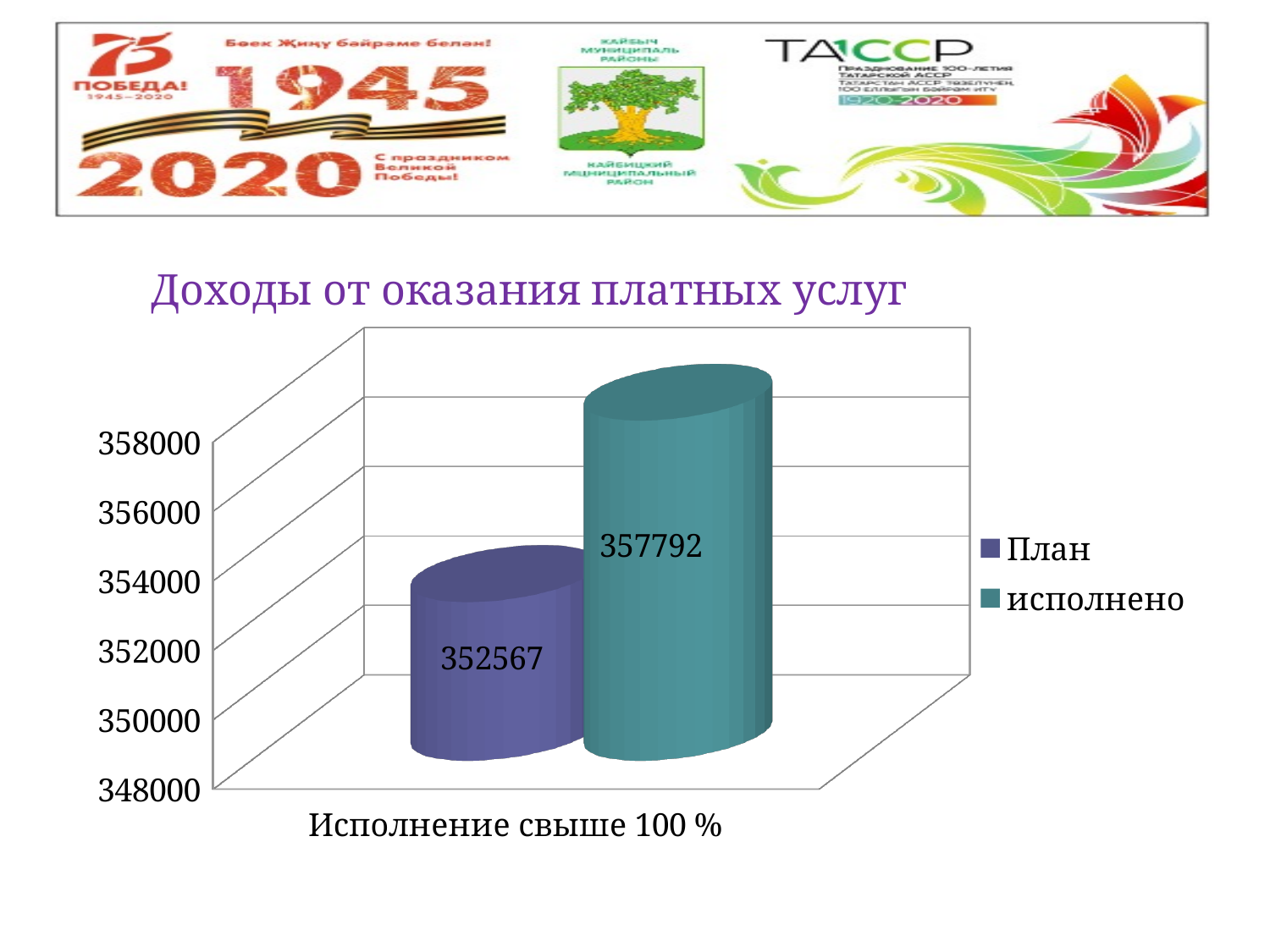
Which series has the lowest value? План Is the value for исполнено greater or less than 356000? greater How many bars are plotted in the chart? 2 Is the value for План greater or less than 354000? less What is the title of the chart? Доходы от оказания платных услуг What is the category label shown below the bars? Исполнение свыше 100 % How many series does the legend list? 2 What is the difference between the исполнено value and the План value? 5225 What is the value for План (plan)? 352567 What is the value for исполнено (executed)? 357792 What kind of chart is shown on the slide? bar chart Which series has the higher value, План or исполнено? исполнено